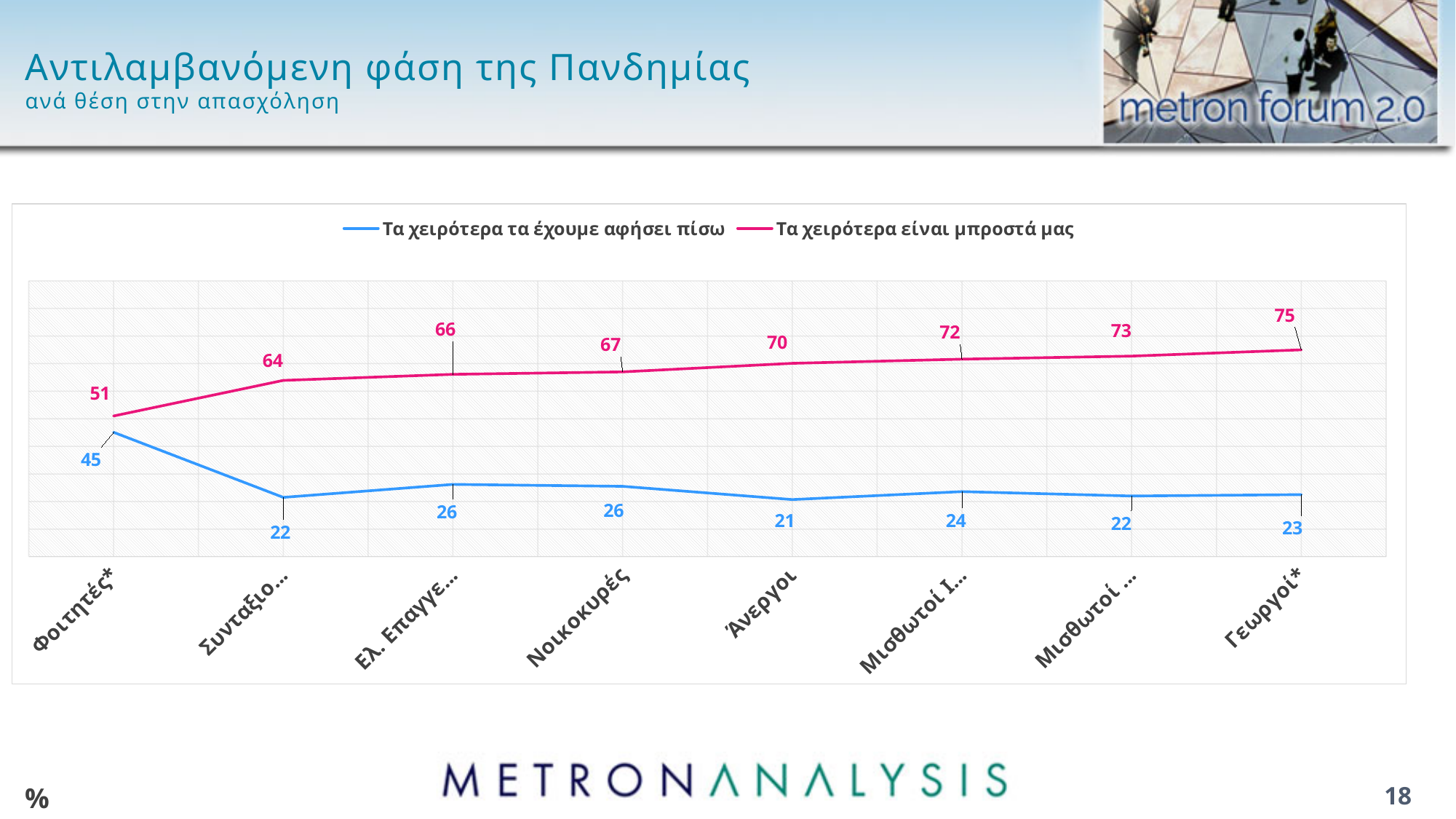
What is the value of the series "Τα χειρότερα τα έχουμε αφήσει πίσω" for Νοικοκυρές? 26 What is the value of the series "Τα χειρότερα τα έχουμε αφήσει πίσω" for Άνεργοι? 21 What kind of chart is shown on the slide? Line chart Which category has the lowest value for the series "Τα χειρότερα τα έχουμε αφήσει πίσω"? Άνεργοι What is the value of the series "Τα χειρότερα είναι μπροστά μας" for Φοιτητές*? 51 How many categories are shown on the x axis of the chart? 8 Which category has the highest value for the series "Τα χειρότερα τα έχουμε αφήσει πίσω"? Φοιτητές* How many series does the legend list? 2 For Γεωργοί*, what is the difference between the value of "Τα χειρότερα είναι μπροστά μας" and the value of "Τα χειρότερα τα έχουμε αφήσει πίσω"? 52 What is the value of the series "Τα χειρότερα είναι μπροστά μας" for Γεωργοί*? 75 For the series "Τα χειρότερα τα έχουμε αφήσει πίσω", which is larger: the value for Φοιτητές* or the value for Άνεργοι? Φοιτητές* Which category has the highest value for the series "Τα χειρότερα είναι μπροστά μας"? Γεωργοί*